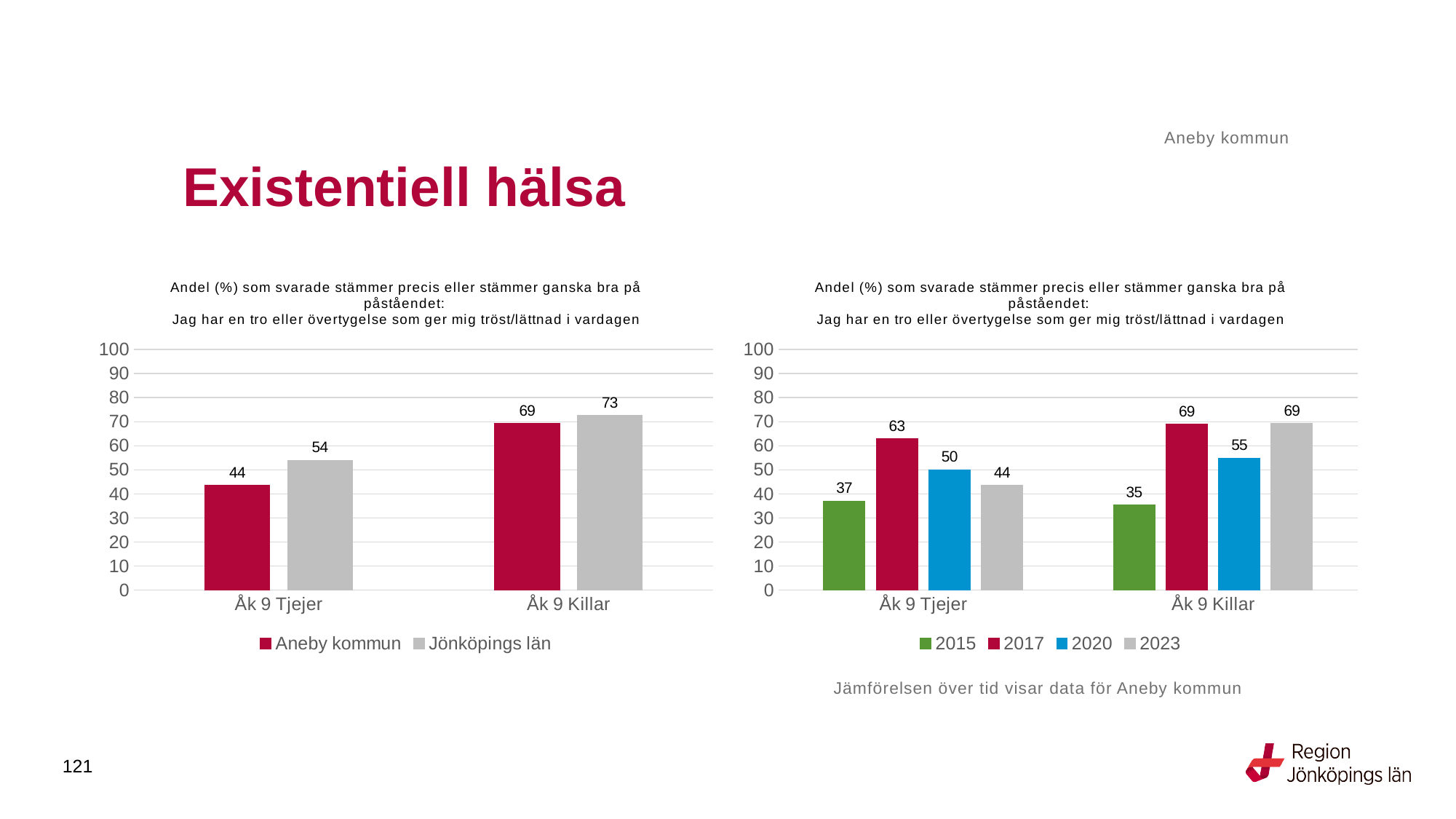
In the right chart, what is the value for 2020 for Åk 9 Tjejer? 50 In the left chart, what is the value for Aneby kommun for Åk 9 Tjejer? 44 In the left chart, which is larger for Åk 9 Killar: Aneby kommun or Jönköpings län? Jönköpings län In the left chart, what is the value for Jönköpings län for Åk 9 Killar? 73 In the right chart, what is the difference between the 2017 and 2023 values for Åk 9 Tjejer? 19 In the right chart, which year has the highest value for Åk 9 Tjejer? 2017 In the left chart, what is the difference between Jönköpings län and Aneby kommun for Åk 9 Tjejer? 10 What kind of chart is the right chart? Bar chart In the left chart, how many series does the legend list? 2 In the right chart, what is the value for 2015 for Åk 9 Killar? 35 In the right chart, how many series does the legend list? 4 In the right chart, which year has the lowest value for Åk 9 Killar? 2015